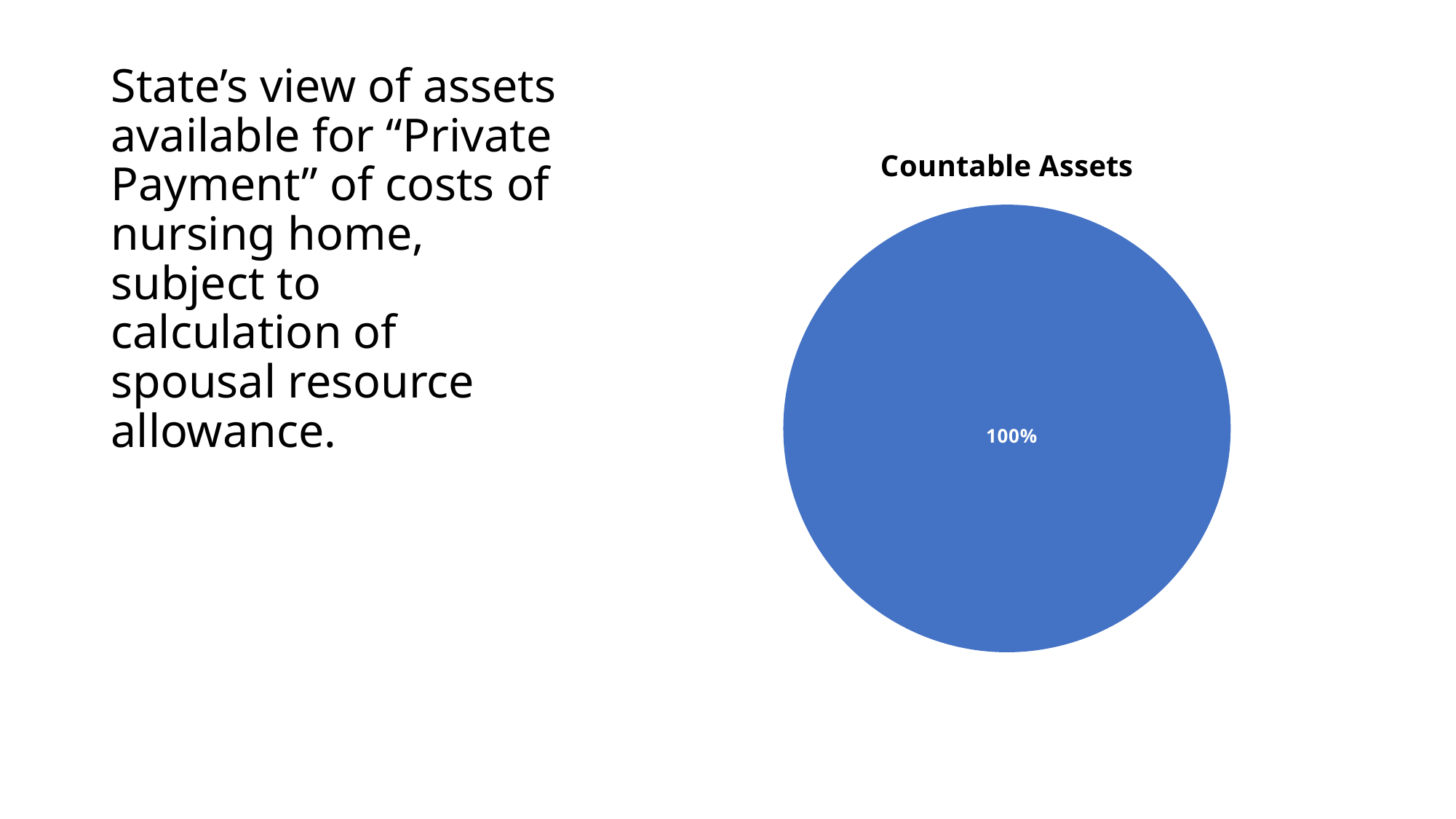
What colour is the slice in the pie chart? blue How many slices does the pie chart have? 1 What share of the pie does the single slice represent? 100% What percentage is printed on the single slice of the pie chart? 100% What kind of chart is shown on the slide? pie chart What is the title of the chart? Countable Assets